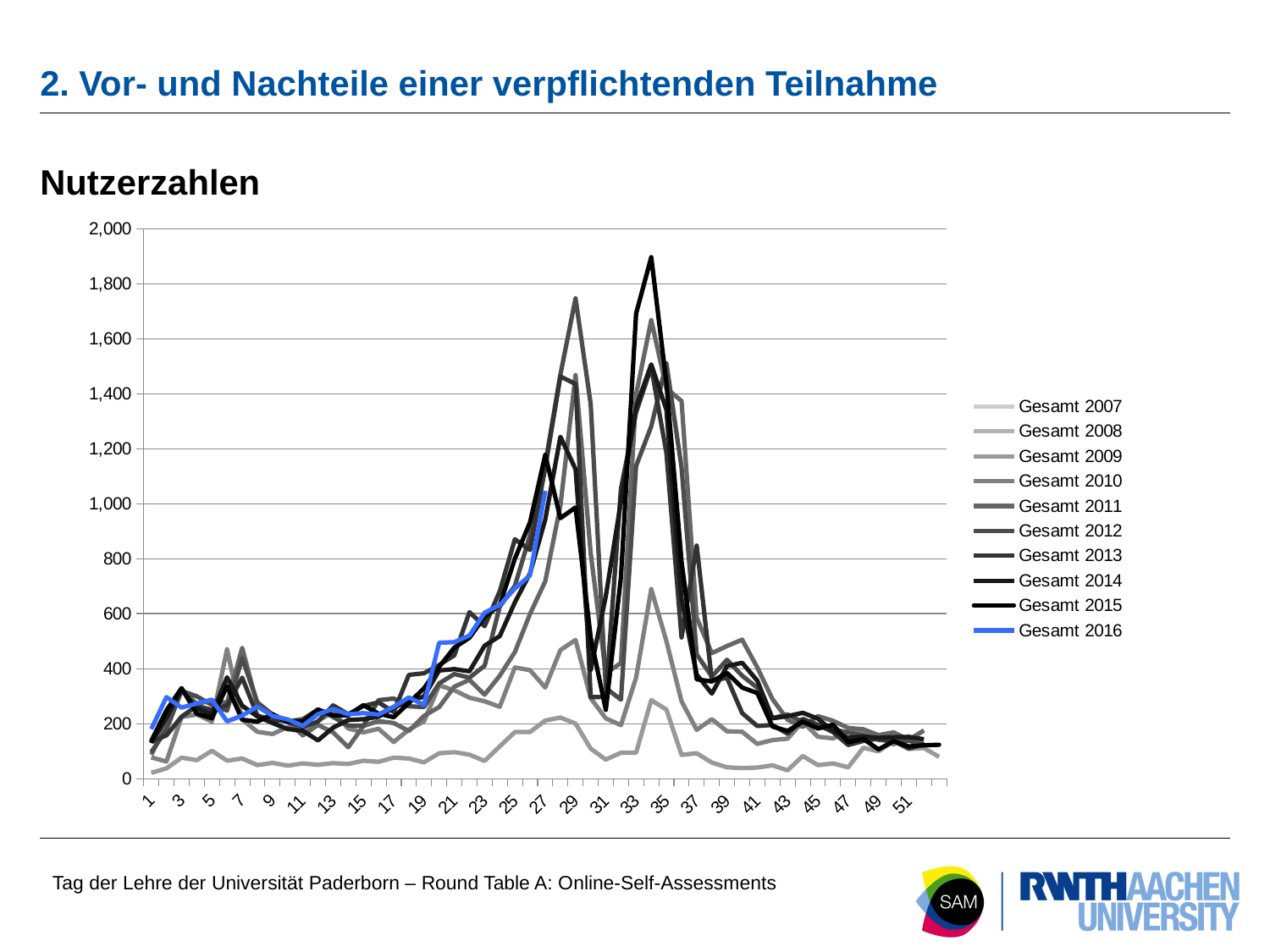
Does the Gesamt 2016 line rise or fall between x = 19 and x = 27? rise Which series reaches the highest value on the chart? Gesamt 2015 Which series is drawn in blue? Gesamt 2016 Is the highest value reached by Gesamt 2015 greater or less than 1,800? greater How many series does the legend list? 10 What is the highest value shown on the y axis? 2,000 What is the title of the chart? Nutzerzahlen What kind of chart is shown on the slide? line chart Is the value for Gesamt 2016 at x = 11 greater or less than 400? less Is the value for Gesamt 2016 at x = 1 greater or less than 400? less